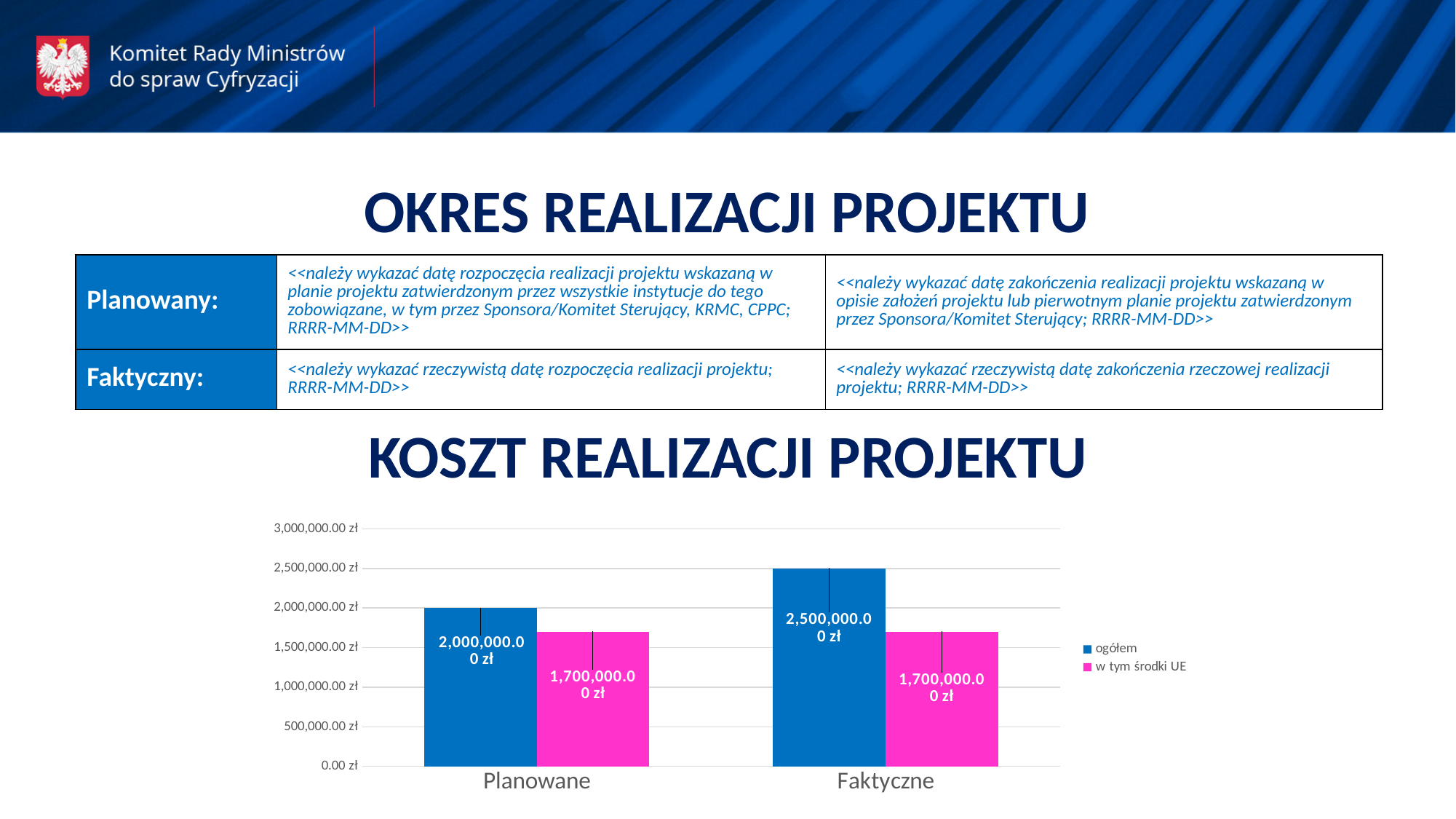
Which is larger for Faktyczne: 'ogółem' or 'w tym środki UE'? ogółem What is the value of 'w tym środki UE' for Planowane? 1,700,000.00 zł What is the value of 'w tym środki UE' for Faktyczne? 1,700,000.00 zł What is the value of 'ogółem' for Planowane? 2,000,000.00 zł How many categories are shown on the x axis? 2 What is the difference between the 'ogółem' values for Faktyczne and Planowane? 500,000.00 zł How many series does the legend list? 2 What colour are the 'w tym środki UE' bars? Pink (magenta) What is the value of 'ogółem' for Faktyczne? 2,500,000.00 zł What kind of chart is shown under 'KOSZT REALIZACJI PROJEKTU'? Bar chart What is the difference between 'ogółem' and 'w tym środki UE' for Planowane? 300,000.00 zł Which category has the higher 'ogółem' value? Faktyczne